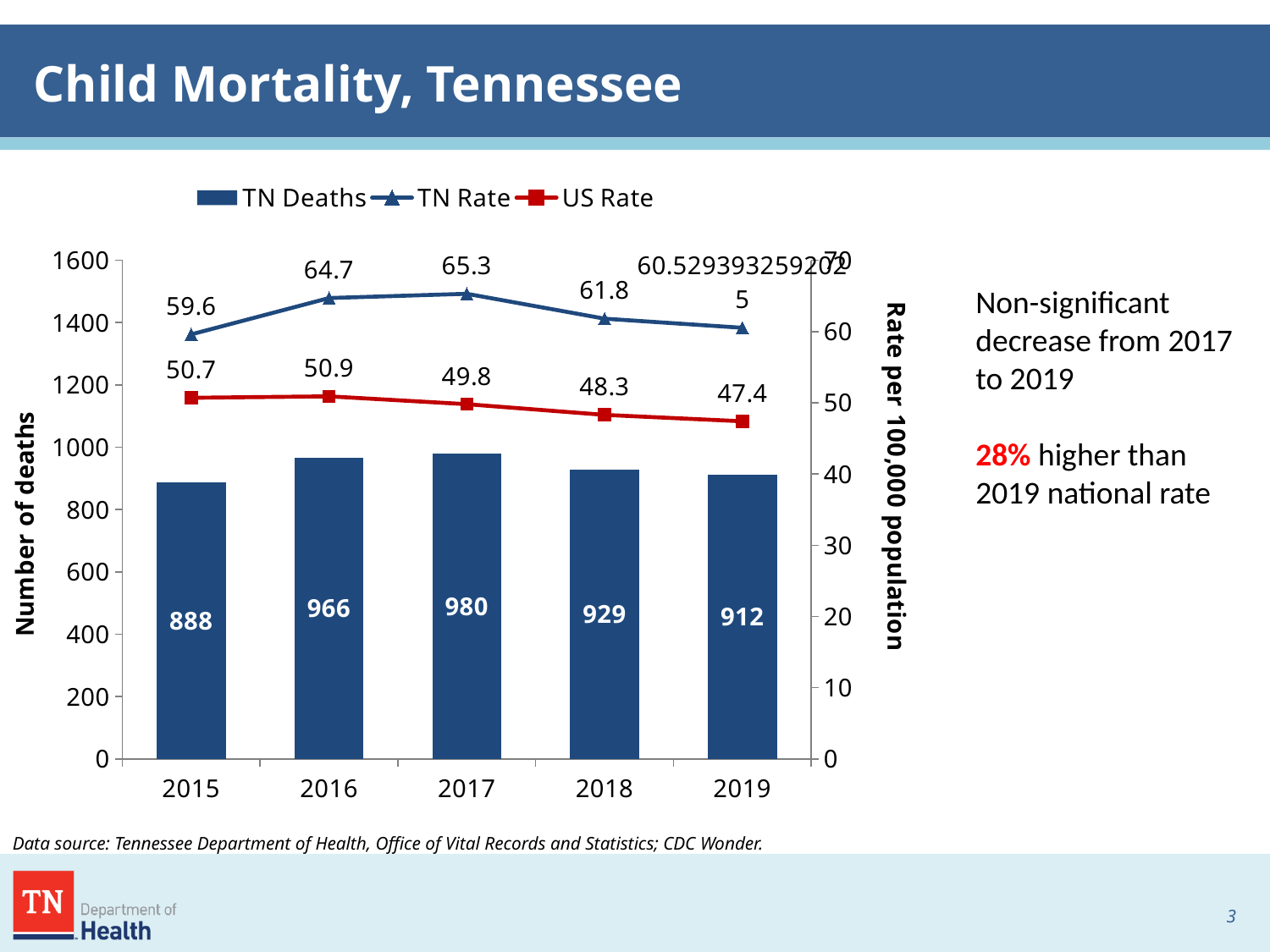
Did the US Rate rise or fall from 2016 to 2019? fall Which was higher in 2018, the TN Rate or the US Rate? TN Rate Which year had the highest number of TN deaths? 2017 How many years are shown on the x axis? 5 How many series does the legend list? 3 What is the difference in TN deaths between 2017 and 2019? 68 Which year had the lowest US Rate? 2019 What was the US Rate in 2019? 47.4 What is the difference between the TN Rate and the US Rate in 2017? 15.5 Which year had the lowest number of TN deaths? 2015 How many TN deaths were there in 2017? 980 What was the TN Rate in 2016? 64.7